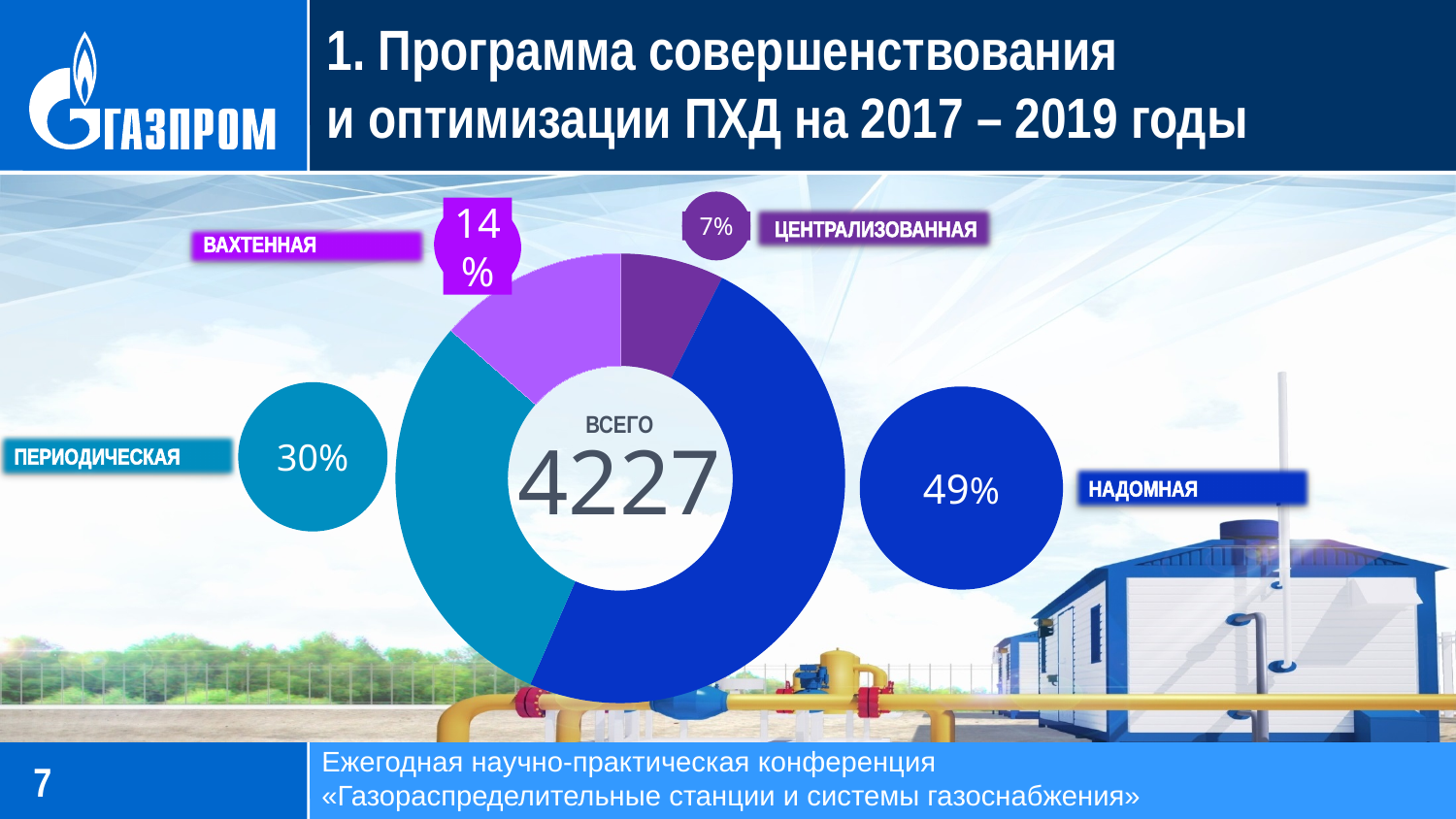
How many categories are shown in the donut chart? 4 Which category has the largest share in the donut chart? НАДОМНАЯ Which category has the smallest share in the donut chart? ЦЕНТРАЛИЗОВАННАЯ What kind of chart is shown on the slide? Donut (pie) chart What share of the donut chart does НАДОМНАЯ account for? 49% What share of the donut chart does ЦЕНТРАЛИЗОВАННАЯ account for? 7% What share of the donut chart does ВАХТЕННАЯ account for? 14% What share of the donut chart does ПЕРИОДИЧЕСКАЯ account for? 30% What total value (ВСЕГО) is shown in the centre of the donut chart? 4227 What is the difference in percentage points between the НАДОМНАЯ and ПЕРИОДИЧЕСКАЯ shares? 19 What colour is the НАДОМНАЯ segment of the donut chart? Dark blue Which has a larger share, ВАХТЕННАЯ or ЦЕНТРАЛИЗОВАННАЯ? ВАХТЕННАЯ